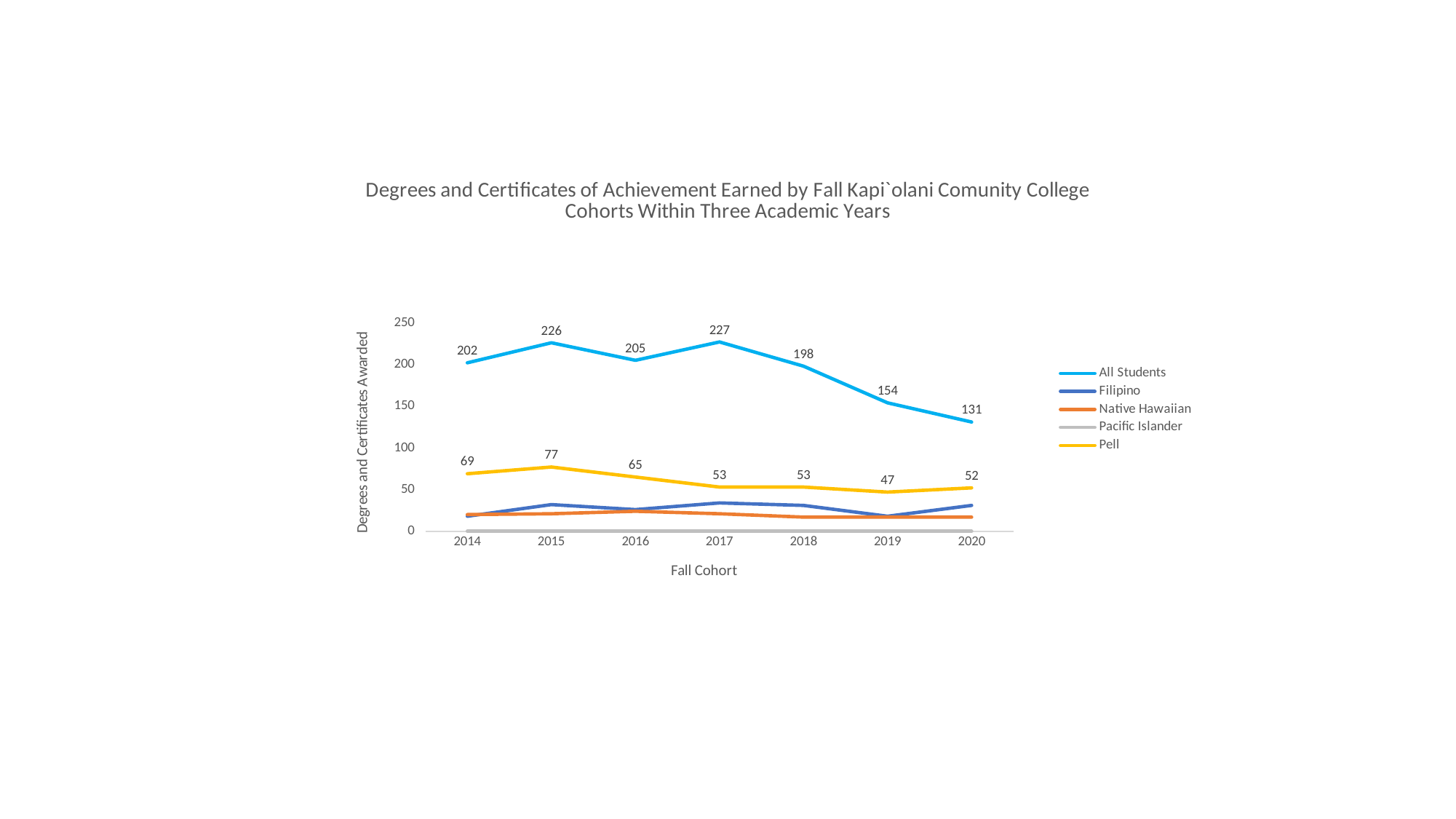
Which cohort year has the highest value for All Students? 2017 Is the value for Filipino in 2015 greater or less than 50? less What is the difference between the All Students values for 2014 and 2020? 71 Does the All Students line rise or fall from 2017 to 2020? fall How many cohort years are shown on the x axis? 7 What is the value for All Students in the 2020 cohort? 131 What is the value for All Students in the 2017 cohort? 227 Which is larger, the Pell value for 2016 or the Pell value for 2018? 2016 What is the value for Pell in the 2015 cohort? 77 What kind of chart is shown on the slide? line chart How many series does the legend list? 5 Which cohort year has the lowest value for Pell? 2019